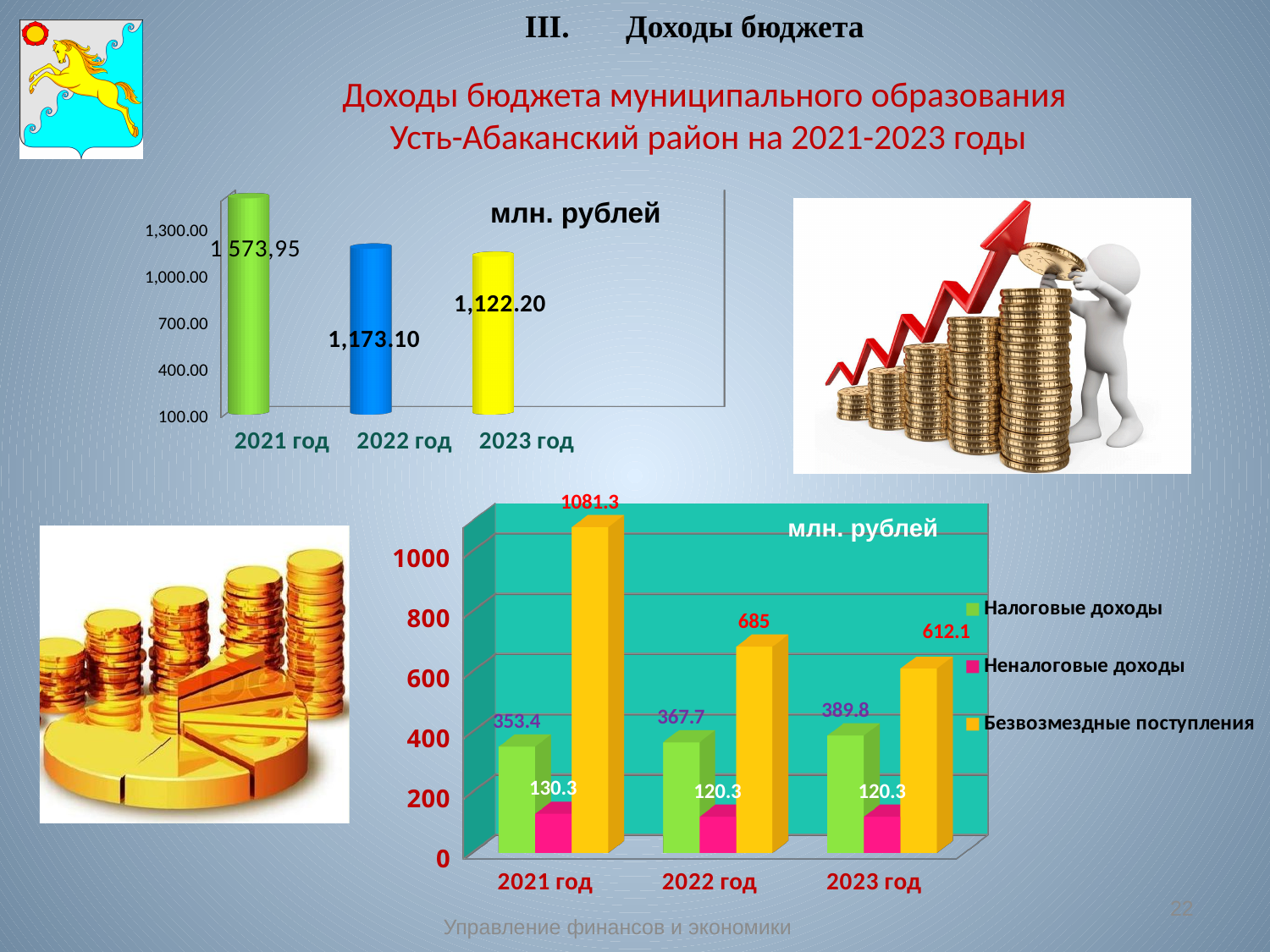
In the bottom chart, what is the value of Безвозмездные поступления for 2021 год? 1081.3 In the bottom chart, what is the value of Налоговые доходы for 2023 год? 389.8 In the top-left bar chart, what is the value for 2022 год? 1,173.10 In the bottom chart, what is the value of Неналоговые доходы for 2022 год? 120.3 In the bottom chart, which is larger for 2022 год: Налоговые доходы or Безвозмездные поступления? Безвозмездные поступления In the bottom chart, how many series does the legend list? 3 In the top-left bar chart, how many years are shown? 3 What kind of chart is the bottom chart? bar chart In the top-left bar chart, which year has the highest value? 2021 год In the top-left bar chart, what is the difference between the values for 2022 год and 2023 год? 50.90 In the bottom chart, do the values of Безвозмездные поступления rise or fall from 2021 год to 2023 год? fall In the top-left bar chart, what is the value for 2023 год? 1,122.20